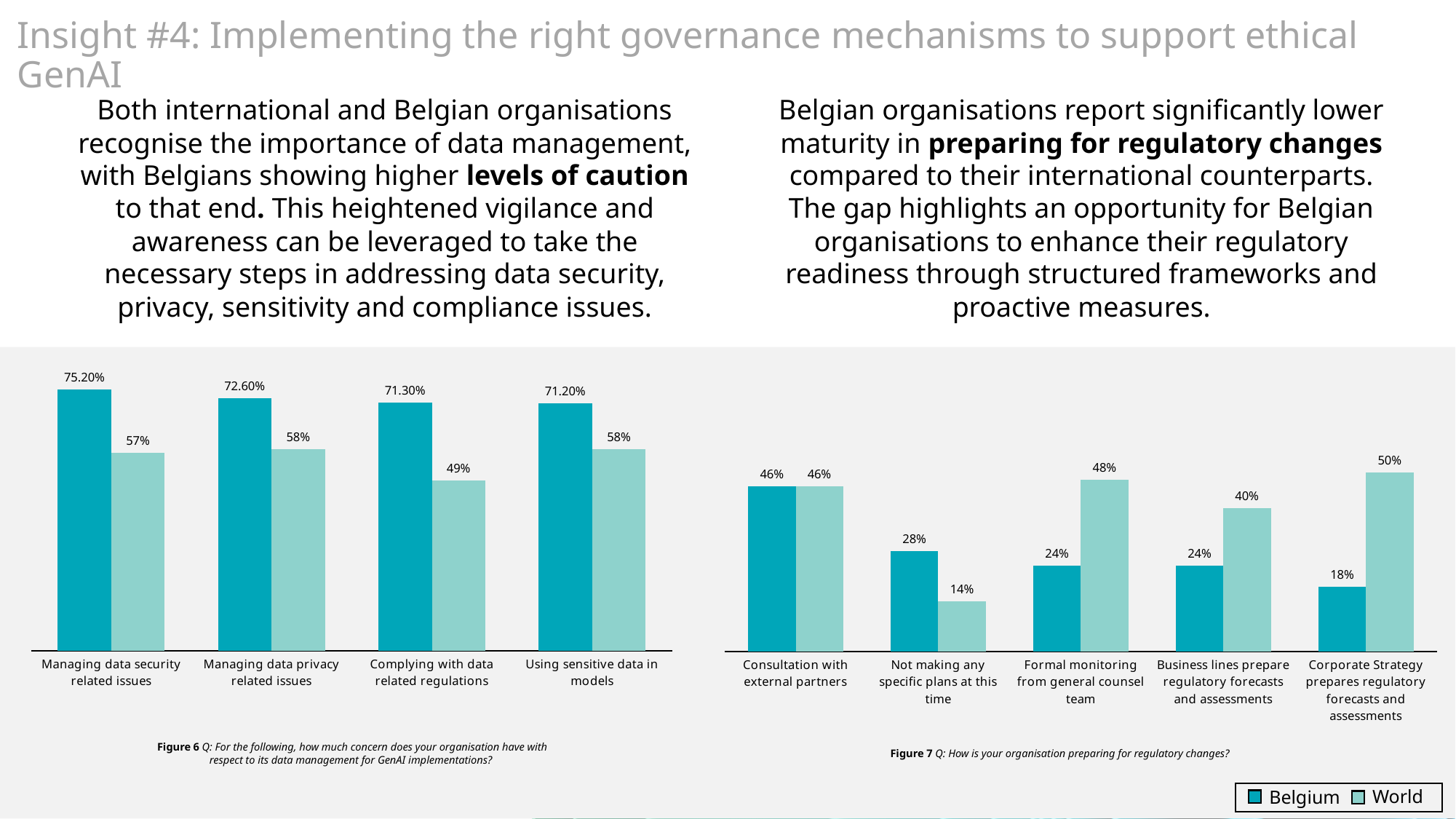
In the left chart (Figure 6), what is the World value for 'Complying with data related regulations'? 49% In the right chart (Figure 7), which category has the lowest World value? Not making any specific plans at this time In the left chart (Figure 6), how many categories are shown on the x axis? 4 In the right chart (Figure 7), what is the Belgium value for 'Not making any specific plans at this time'? 28% In the right chart (Figure 7), what is the World value for 'Corporate Strategy prepares regulatory forecasts and assessments'? 50% How many series does the legend list for the charts on the slide? 2 In the right chart (Figure 7), what is the difference between the World and Belgium values for 'Business lines prepare regulatory forecasts and assessments'? 16% In the left chart (Figure 6), what is the difference between the Belgium and World values for 'Managing data privacy related issues'? 14.60% In the right chart (Figure 7), which is larger for 'Formal monitoring from general counsel team': the Belgium value or the World value? World In the left chart (Figure 6), which category has the highest Belgium value? Managing data security related issues In the left chart (Figure 6), which category has the lowest World value? Complying with data related regulations In the left chart (Figure 6), what is the Belgium value for 'Managing data security related issues'? 75.20%